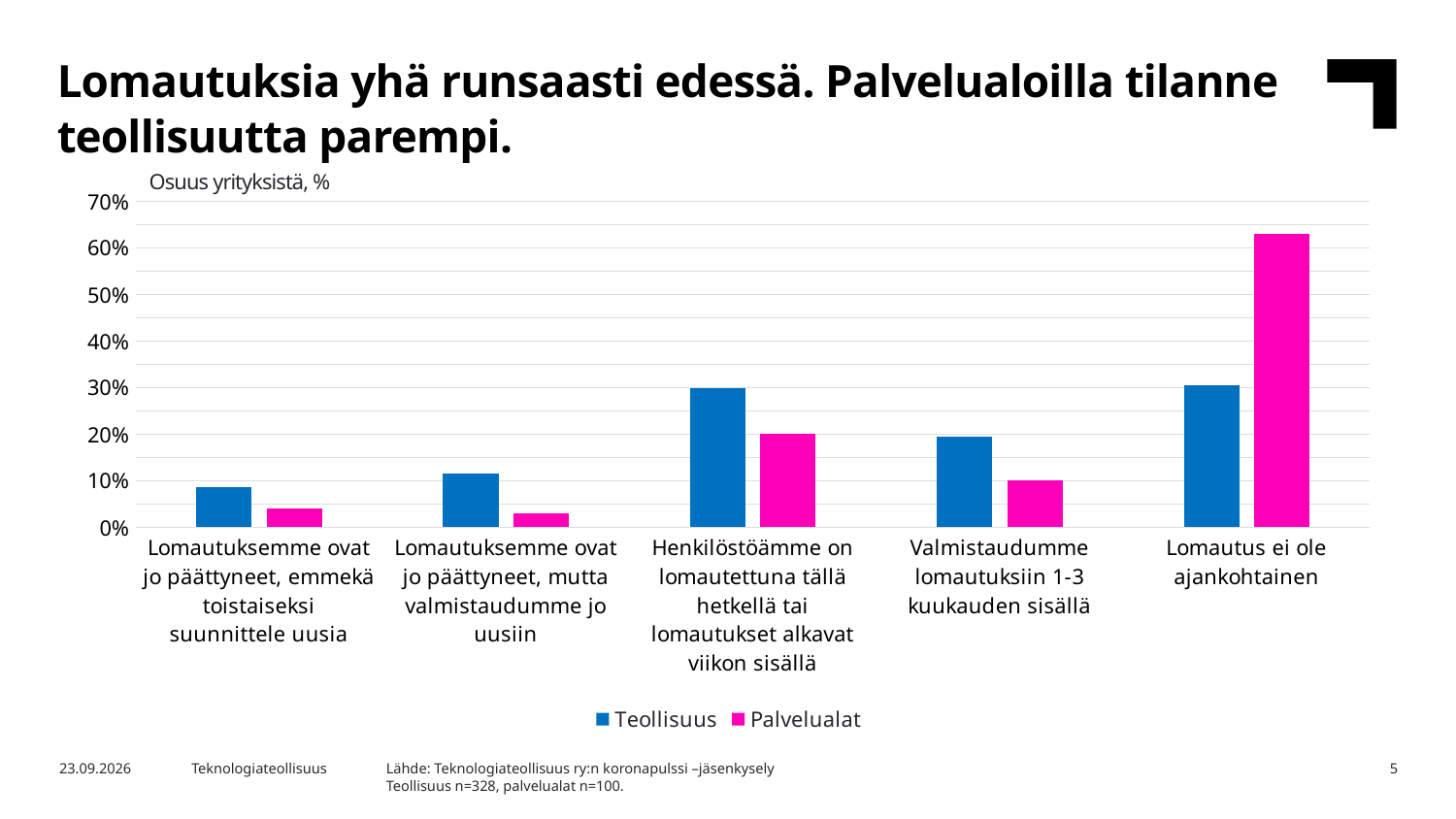
Is the Palvelualat value for 'Valmistaudumme lomautuksiin 1-3 kuukauden sisällä' greater or less than 20%? less For which category is the Teollisuus value lowest? Lomautuksemme ovat jo päättyneet, emmekä toistaiseksi suunnittele uusia Is the Teollisuus value for 'Henkilöstöämme on lomautettuna tällä hetkellä tai lomautukset alkavat viikon sisällä' greater or less than 20%? greater For 'Lomautus ei ole ajankohtainen', which series has the larger value, Teollisuus or Palvelualat? Palvelualat What are the two series named in the legend? Teollisuus and Palvelualat Is the Palvelualat value for 'Lomautus ei ole ajankohtainen' greater or less than 60%? greater For which category is the Palvelualat value highest? Lomautus ei ole ajankohtainen How many categories are shown on the x axis? 5 How many series does the legend list? 2 For 'Henkilöstöämme on lomautettuna tällä hetkellä tai lomautukset alkavat viikon sisällä', which series has the larger value, Teollisuus or Palvelualat? Teollisuus What kind of chart is shown on the slide? bar chart